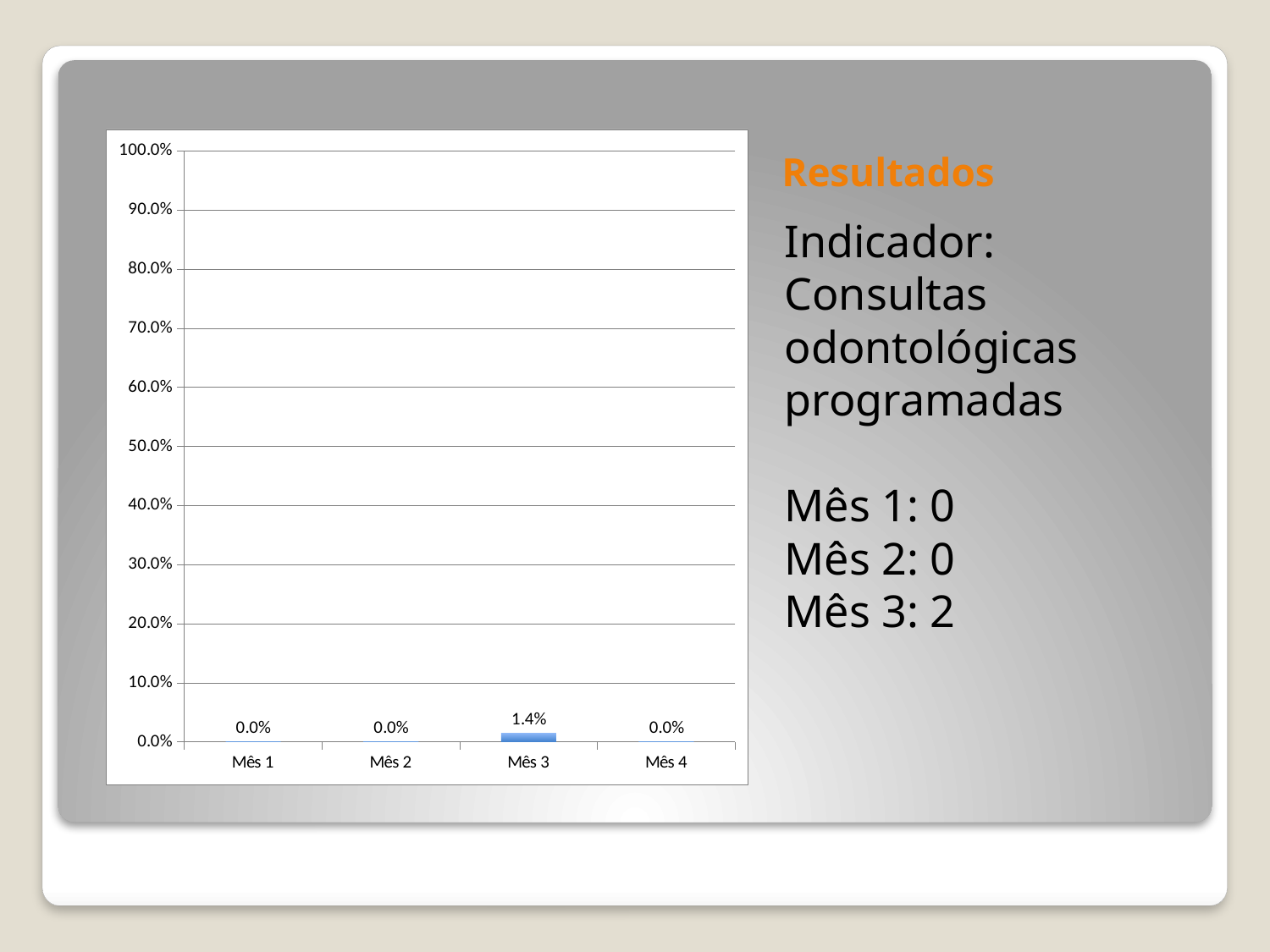
Is the value for Mês 3 greater or less than 10.0%? less How many months have a value of 0.0%? 3 What is the highest value shown on the y axis? 100.0% What is the value for Mês 3? 1.4% Which is larger, the value for Mês 3 or the value for Mês 4? Mês 3 How many months are shown on the x axis? 4 What is the value for Mês 4? 0.0% What is the value for Mês 1? 0.0% What is the difference between the values for Mês 3 and Mês 2? 1.4% What kind of chart is shown? bar chart Which month has the highest value? Mês 3